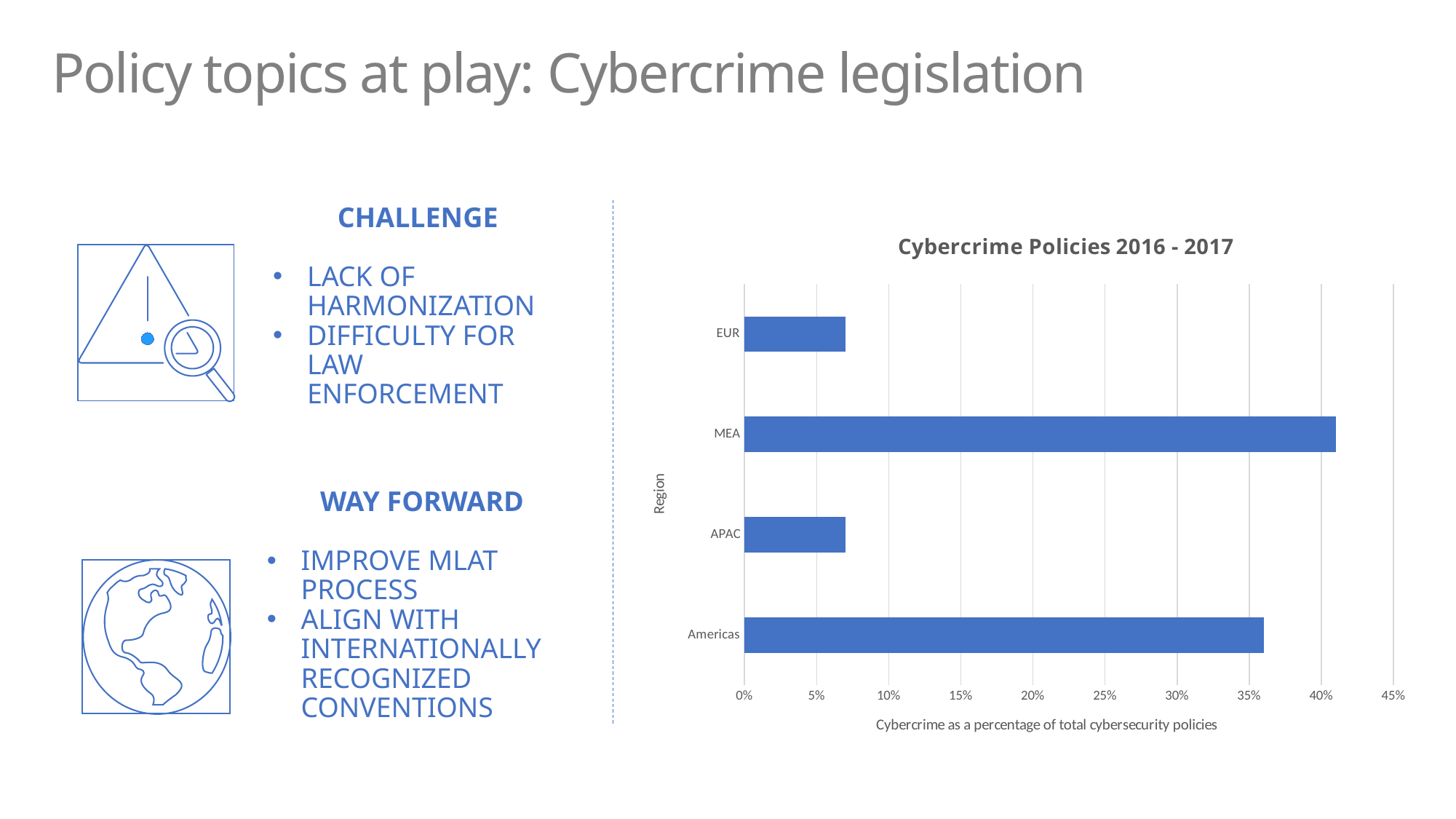
Is the value for Americas greater or less than 40%? less Is the value for APAC greater or less than 5%? greater Is the value for MEA greater or less than 35%? greater How many regions are plotted in the chart? 4 What is the label of the horizontal axis of the chart? Cybercrime as a percentage of total cybersecurity policies Which region has the highest value in the chart? MEA What type of chart is shown on the slide? Bar chart Which region has the larger value, Americas or APAC? Americas What is the title of the chart? Cybercrime Policies 2016 - 2017 Which region has the larger value, MEA or Americas? MEA